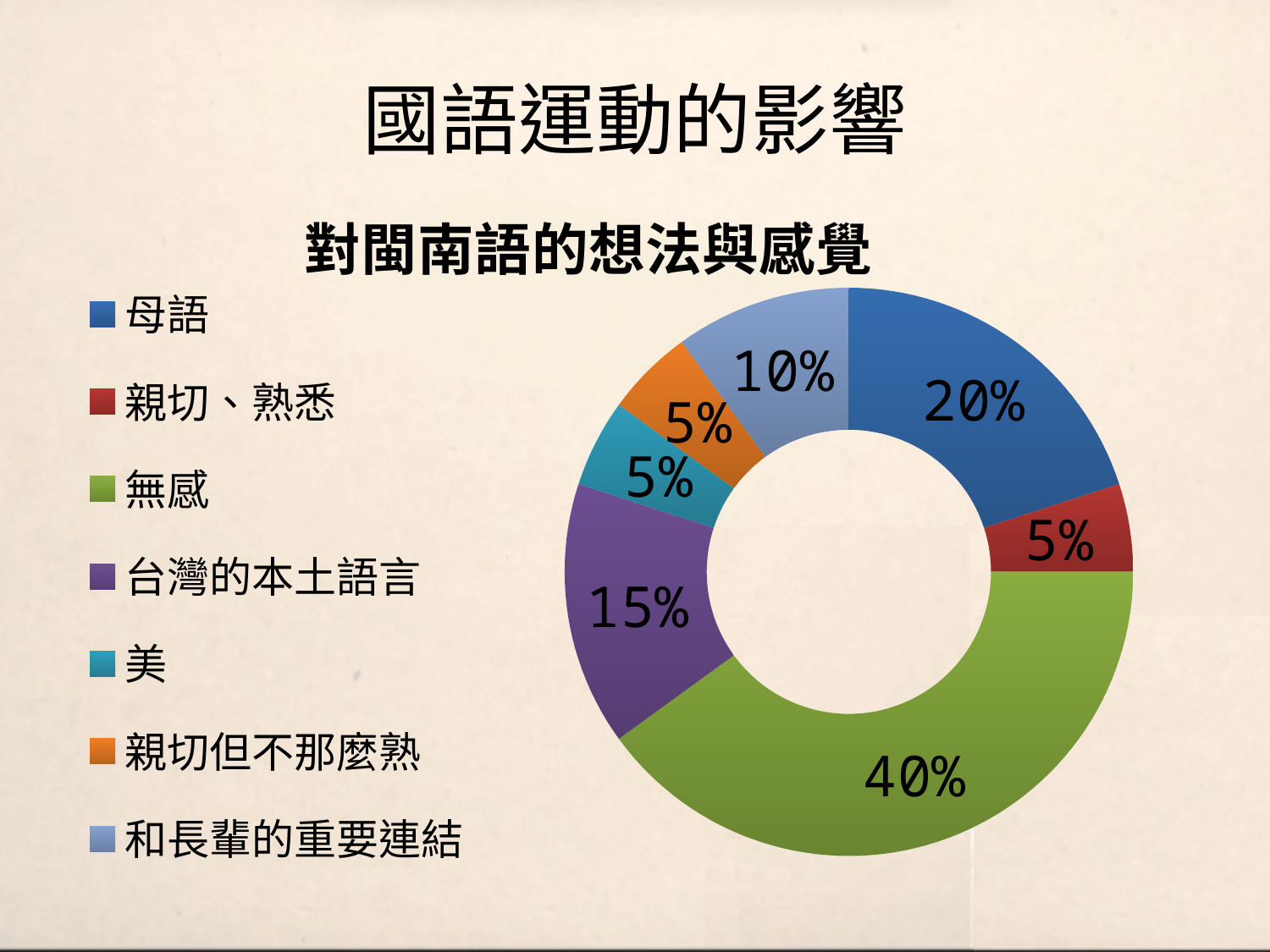
Which category has the largest share of the chart? 無感 What percentage of the chart is labelled 無感? 40% How many categories does the chart show? 7 What kind of chart is shown on the slide? Doughnut chart What percentage is shown for 和長輩的重要連結? 10% What percentage is shown for 台灣的本土語言? 15% What is the title of the chart? 對閩南語的想法與感覺 Which is larger, the share for 母語 or the share for 台灣的本土語言? 母語 What percentage is shown for 美? 5% What is the difference in percentage points between 無感 and 母語? 20 What is the difference in percentage points between 台灣的本土語言 and 和長輩的重要連結? 5 What percentage is shown for 母語? 20%